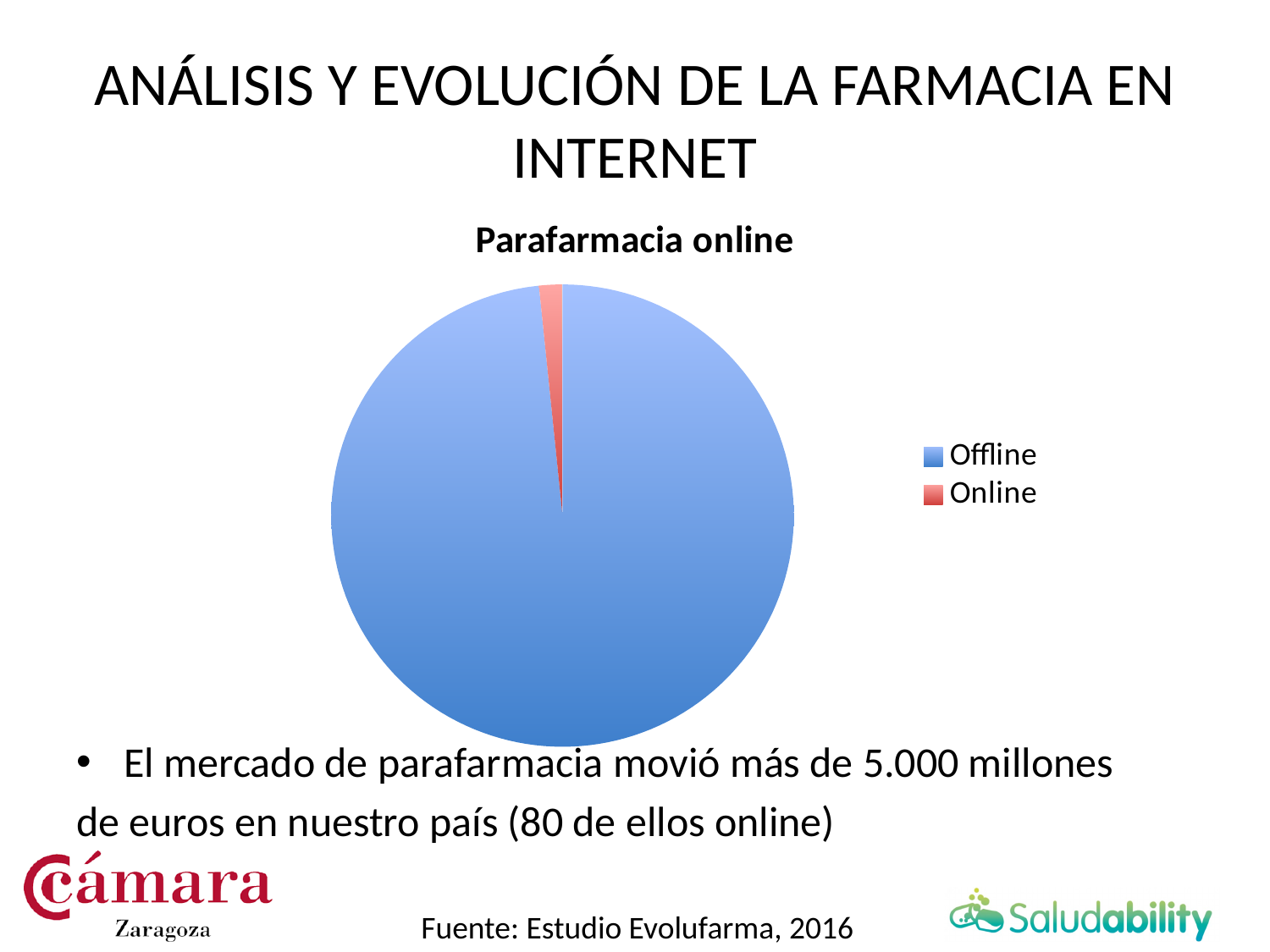
What colour is the Online slice in the pie chart? red What is the title of the chart? Parafarmacia online Which slice is larger, Offline or Online? Offline Which category has the largest slice of the pie? Offline Which category has the smallest slice of the pie? Online What kind of chart is shown on the slide? pie chart How many entries does the chart legend list? 2 How many slices does the pie chart have? 2